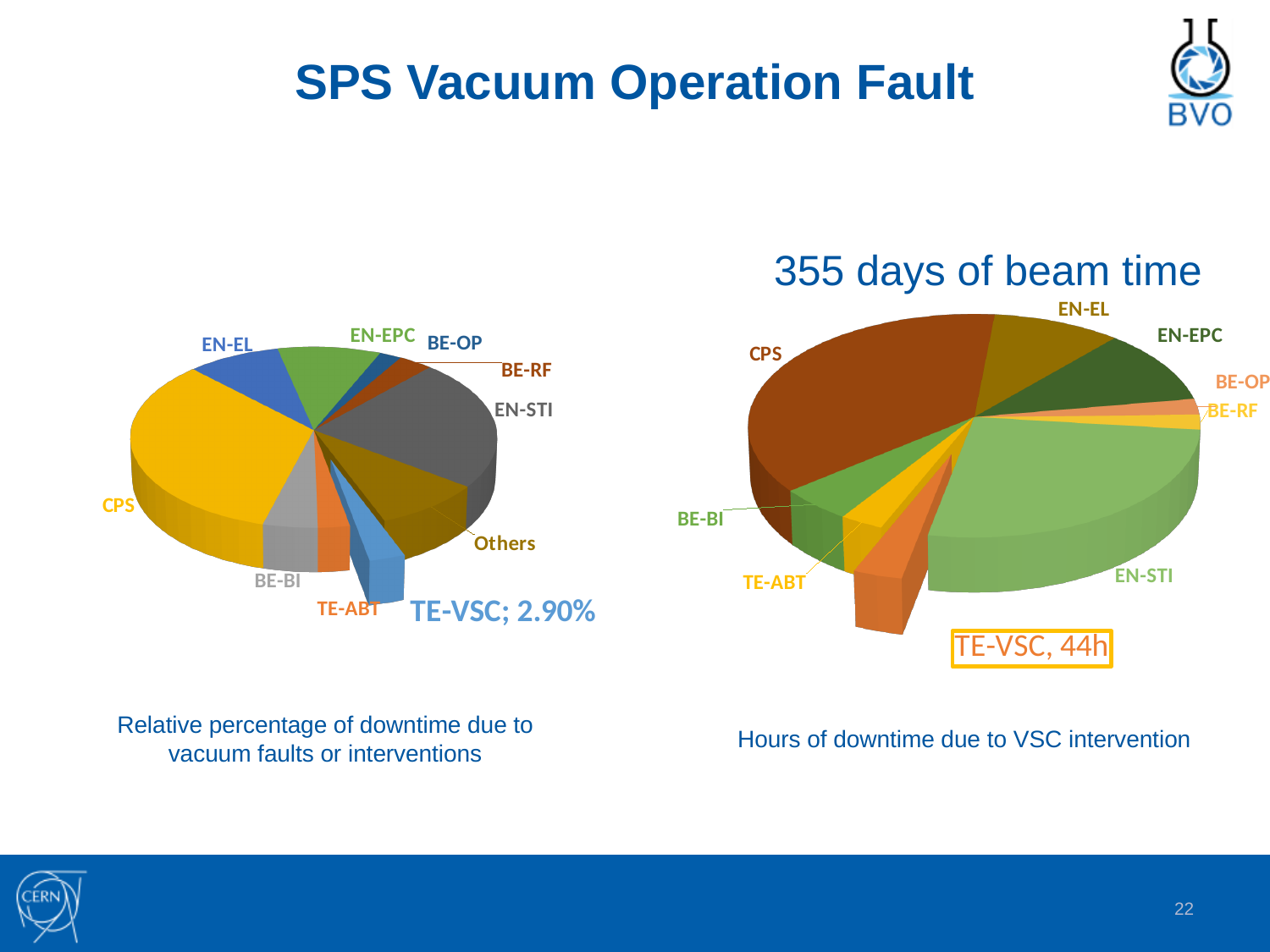
What is the title shown above the right pie chart? 355 days of beam time On the right pie chart (Hours of downtime due to VSC intervention), what is the value shown for TE-VSC? 44h How many categories are labelled on the right pie chart (Hours of downtime due to VSC intervention)? 9 On the left pie chart (Relative percentage of downtime), which category has the largest slice? CPS On the right pie chart (Hours of downtime due to VSC intervention), which slice is larger, CPS or BE-RF? CPS On the left pie chart (Relative percentage of downtime), what is the value shown for TE-VSC? 2.90% On the left pie chart (Relative percentage of downtime), which slice is larger, CPS or EN-STI? CPS What kind of chart is used on the left of the slide? Pie chart How many categories are labelled on the left pie chart (Relative percentage of downtime)? 10 On the right pie chart (Hours of downtime due to VSC intervention), which slice is larger, EN-STI or TE-VSC? EN-STI